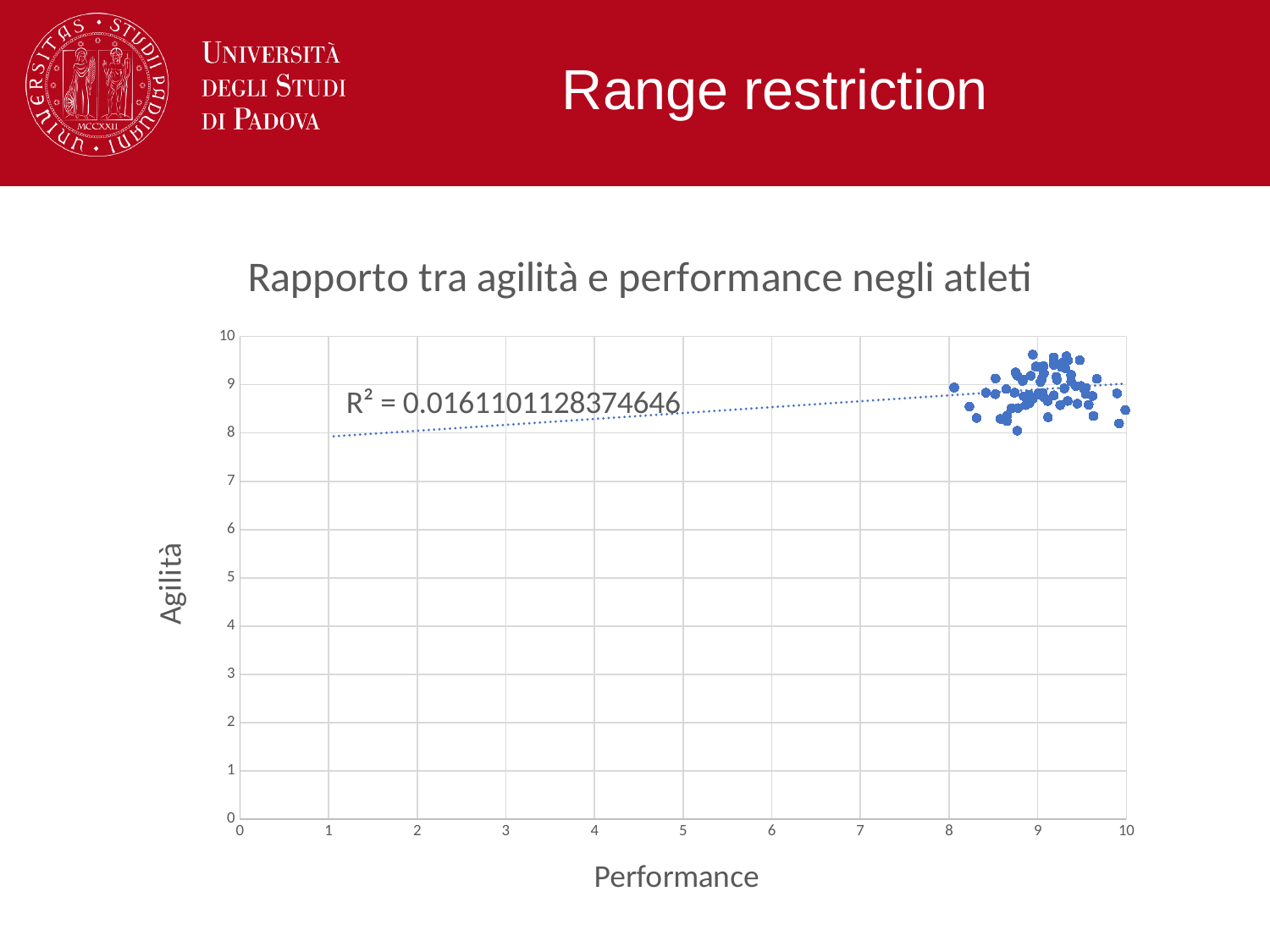
What is the title of the chart? Rapporto tra agilità e performance negli atleti What kind of chart is shown on the slide? scatter chart What is the label of the x axis? Performance What is the maximum value shown on the x axis? 10 Does the dotted trendline rise or fall as Performance increases? rise Are the plotted points' Agilità values greater or less than 7? greater What is the maximum value shown on the y axis? 10 What R² value is printed on the chart? R² = 0.0161101128374646 Is the R² value printed on the chart greater or less than 1? less Are the plotted points' Performance values greater or less than 8? greater